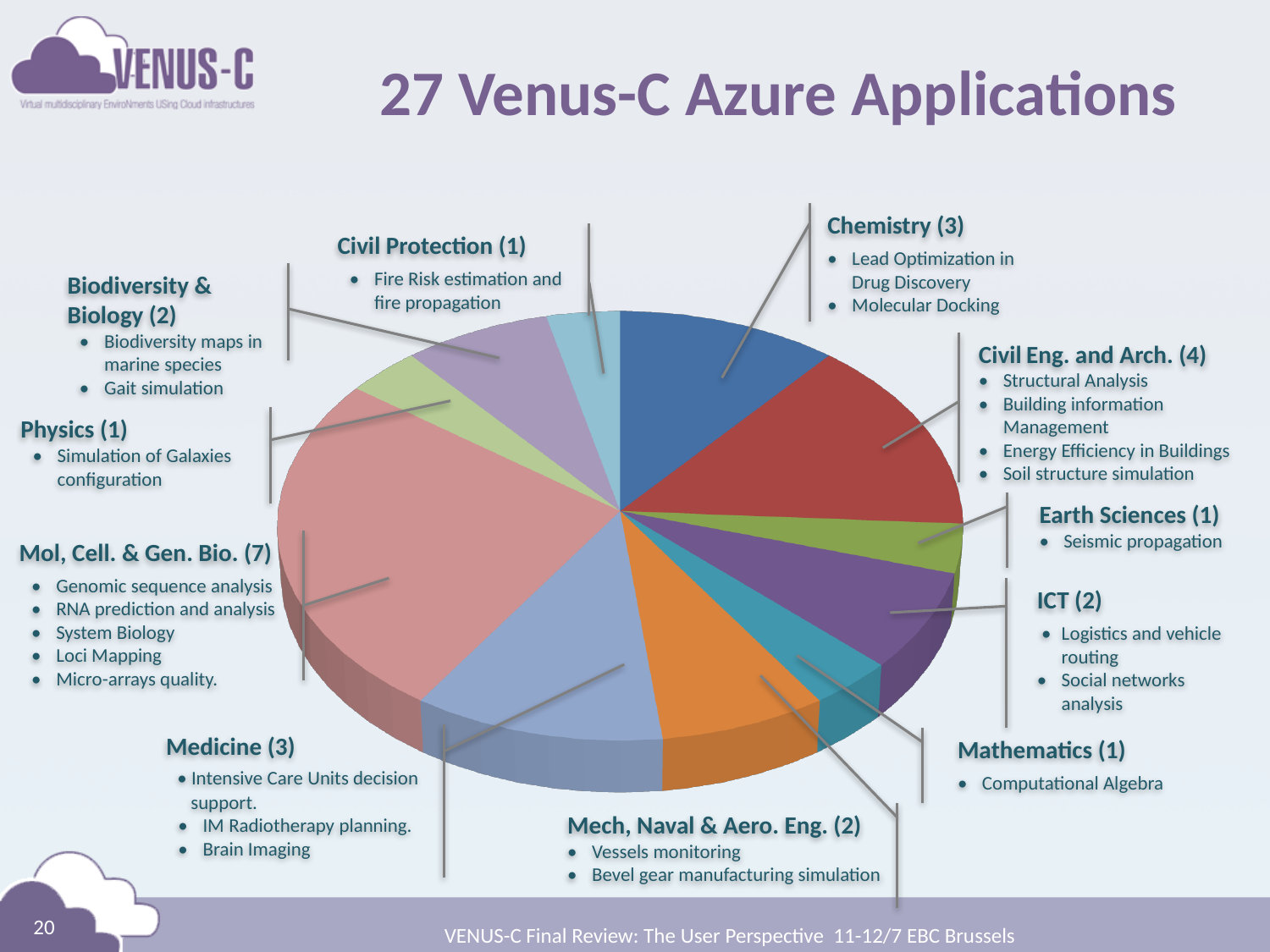
Which has more applications, Civil Eng. and Arch. or Chemistry? Civil Eng. and Arch. What is the difference between the number of applications in Mol, Cell. & Gen. Bio. and in Civil Eng. and Arch.? 3 How many categories are shown in the pie chart? 11 What is the title of the slide? 27 Venus-C Azure Applications Which category has the largest number of applications? Mol, Cell. & Gen. Bio. How many applications does the Chemistry category have? 3 How many applications does the ICT category have? 2 How many applications does the Mol, Cell. & Gen. Bio. category have? 7 What is the difference between the number of applications in Medicine and in Earth Sciences? 2 Which has more applications, Medicine or Mathematics? Medicine How many applications does the Civil Eng. and Arch. category have? 4 What kind of chart is shown on the slide? pie chart